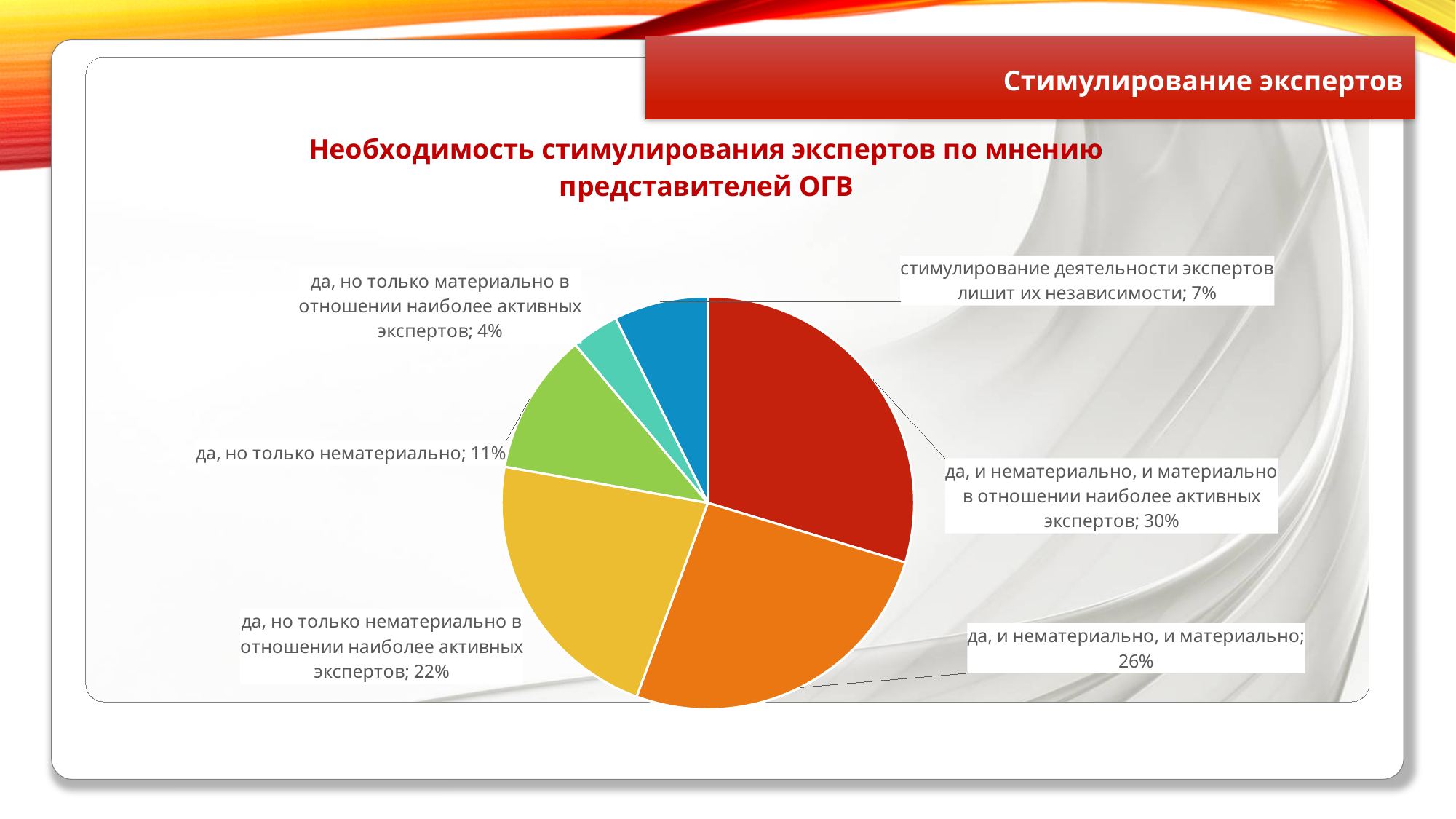
What is the difference between the share for "да, и нематериально, и материально" and the share for "да, но только нематериально в отношении наиболее активных экспертов"? 4% Which category has the largest share of the pie? да, и нематериально, и материально в отношении наиболее активных экспертов Which category has the smallest share of the pie? да, но только материально в отношении наиболее активных экспертов What share of the pie is labelled "да, и нематериально, и материально в отношении наиболее активных экспертов"? 30% What share of the pie is labelled "стимулирование деятельности экспертов лишит их независимости"? 7% What share of the pie is labelled "да, но только нематериально"? 11% What colour is the slice for "да, и нематериально, и материально; 26%"? orange How many slices does the pie chart have? 6 What is the title of the chart? Необходимость стимулирования экспертов по мнению представителей ОГВ What share of the pie is labelled "да, но только нематериально в отношении наиболее активных экспертов"? 22% Which is larger: the share for "да, но только нематериально" or the share for "стимулирование деятельности экспертов лишит их независимости"? да, но только нематериально What type of chart is shown on the slide? pie chart